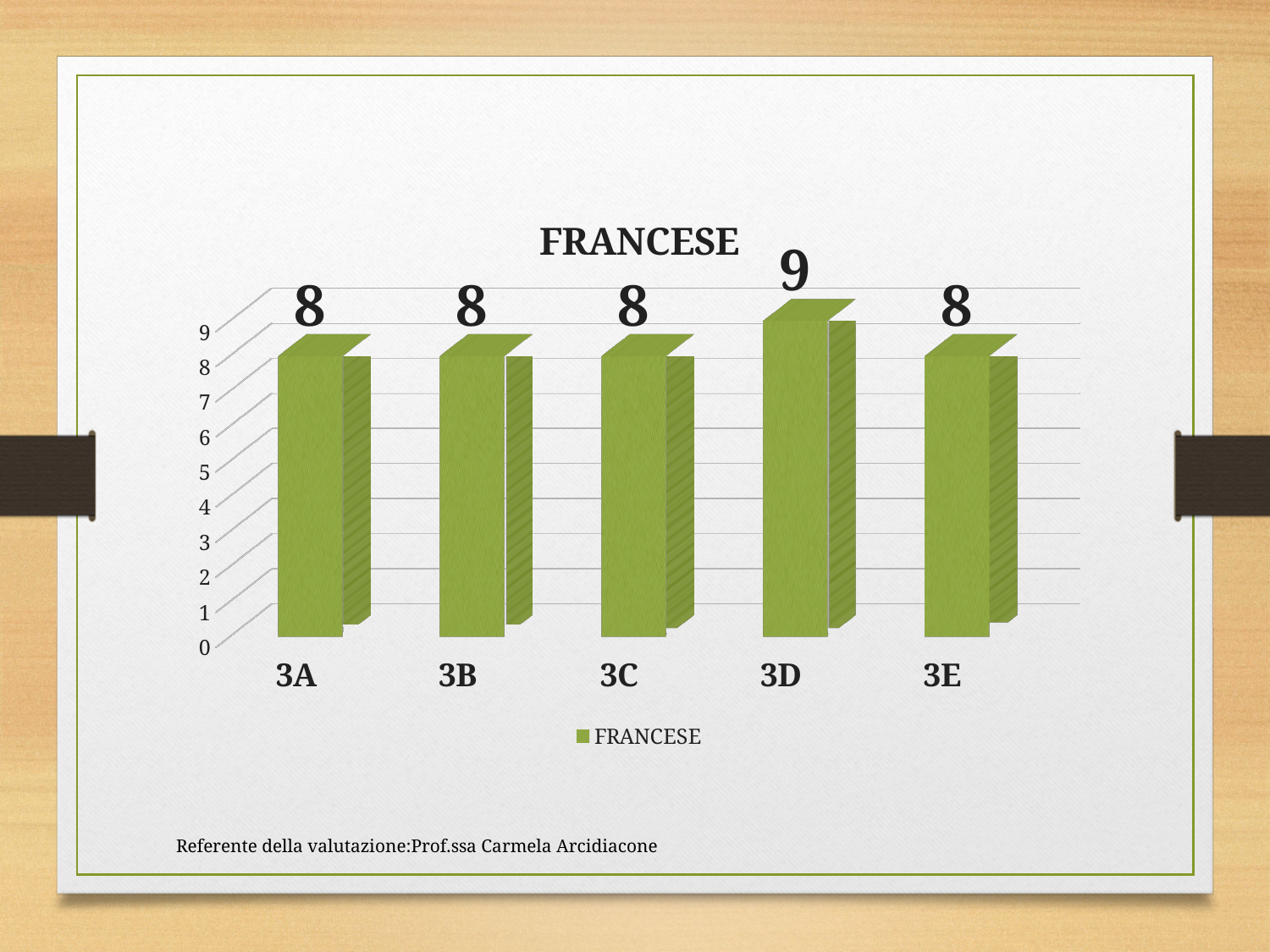
What is the value for 3E? 8 What kind of chart is shown? bar chart What is the difference between the values for 3D and 3B? 1 Is the value for 3D greater or less than 5? greater What is the value for 3A? 8 Which category has the highest value? 3D How many categories are shown on the x axis? 5 Which is larger, the value for 3D or the value for 3C? 3D What is the value for 3D? 9 How many series does the legend list? 1 What is the title of the chart? FRANCESE What is the maximum value shown on the vertical axis? 9